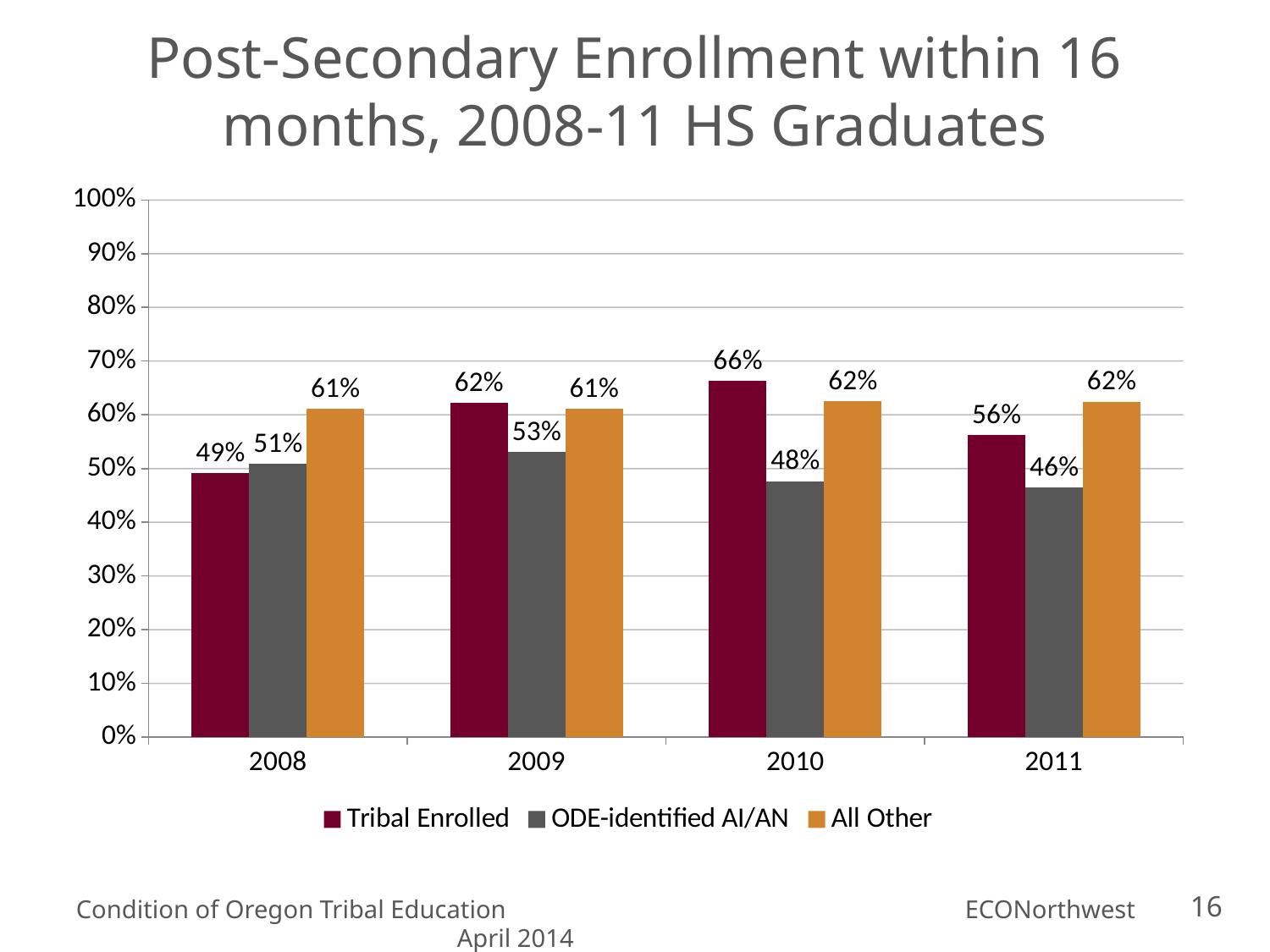
What is the ODE-identified AI/AN value for 2011? 46% What kind of chart is shown on the slide? bar chart What is the All Other value for 2008? 61% In which year is the Tribal Enrolled value highest? 2010 How many years are shown on the x axis? 4 What is the difference between the Tribal Enrolled and ODE-identified AI/AN values in 2010? 18% Is the Tribal Enrolled value for 2008 greater or less than 50%? less Which is larger in 2009: the Tribal Enrolled value or the ODE-identified AI/AN value? Tribal Enrolled In which year is the ODE-identified AI/AN value lowest? 2011 What is the Tribal Enrolled value for 2010? 66% How many series does the legend list? 3 What is the difference between the All Other and Tribal Enrolled values in 2008? 12%